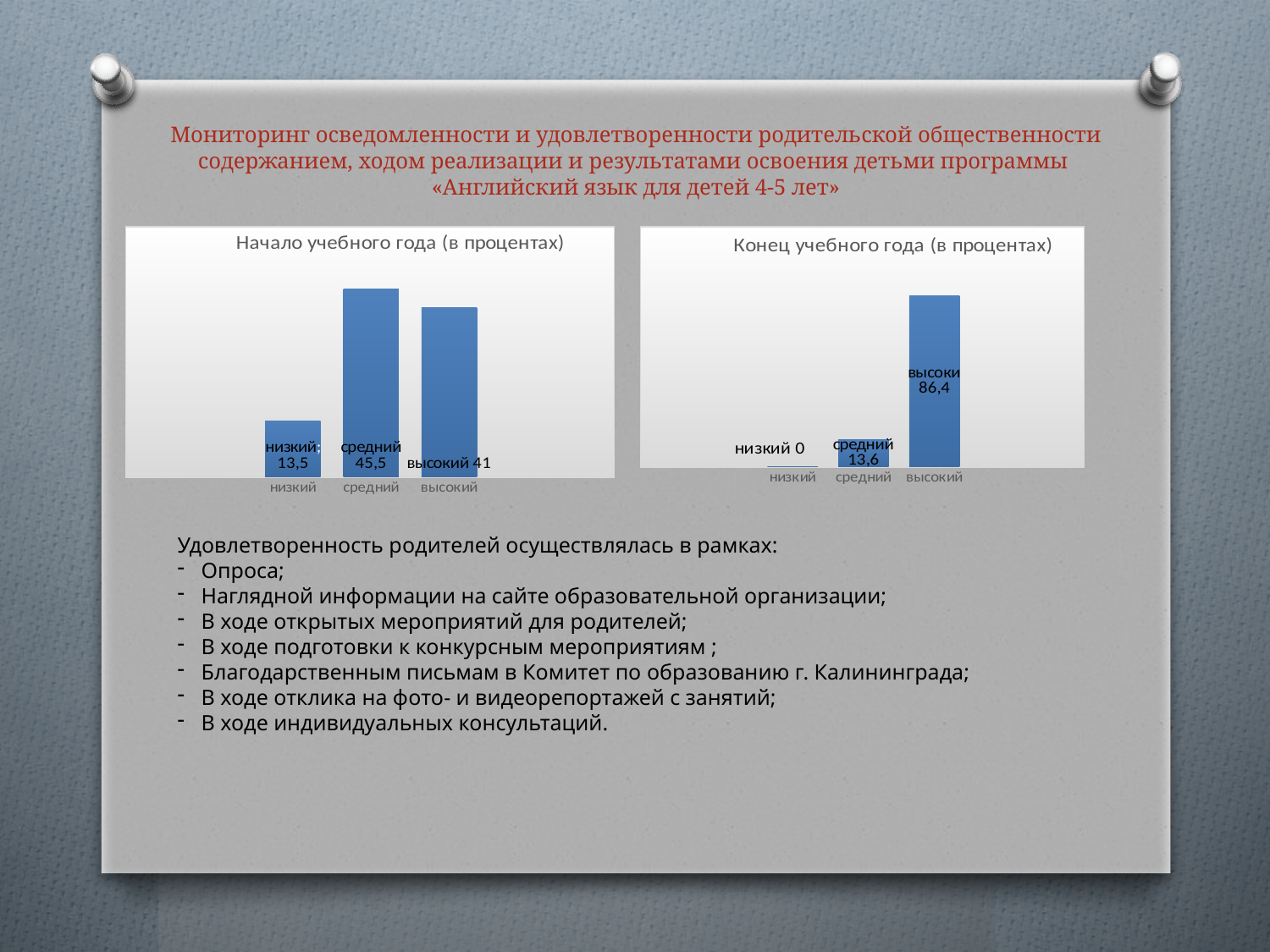
What is the title of the chart on the right side of the slide? Конец учебного года (в процентах) In the chart titled «Конец учебного года (в процентах)», what is the value for «низкий»? 0 In the chart titled «Конец учебного года (в процентах)», what is the difference between the values for «высокий» and «средний»? 72,8 In the chart titled «Начало учебного года (в процентах)», which category has the highest value? средний In the chart titled «Начало учебного года (в процентах)», what is the value for «средний»? 45,5 In the chart titled «Начало учебного года (в процентах)», what is the value for «низкий»? 13,5 In the chart titled «Конец учебного года (в процентах)», which category has the lowest value? низкий In the chart titled «Начало учебного года (в процентах)», what is the difference between the values for «средний» and «высокий»? 4,5 What kind of chart is the chart titled «Начало учебного года (в процентах)»? bar chart In the chart titled «Конец учебного года (в процентах)», what is the value for «высокий»? 86,4 In the chart titled «Начало учебного года (в процентах)», which is larger: the value for «низкий» or the value for «высокий»? высокий How many categories are shown in the chart titled «Конец учебного года (в процентах)»? 3